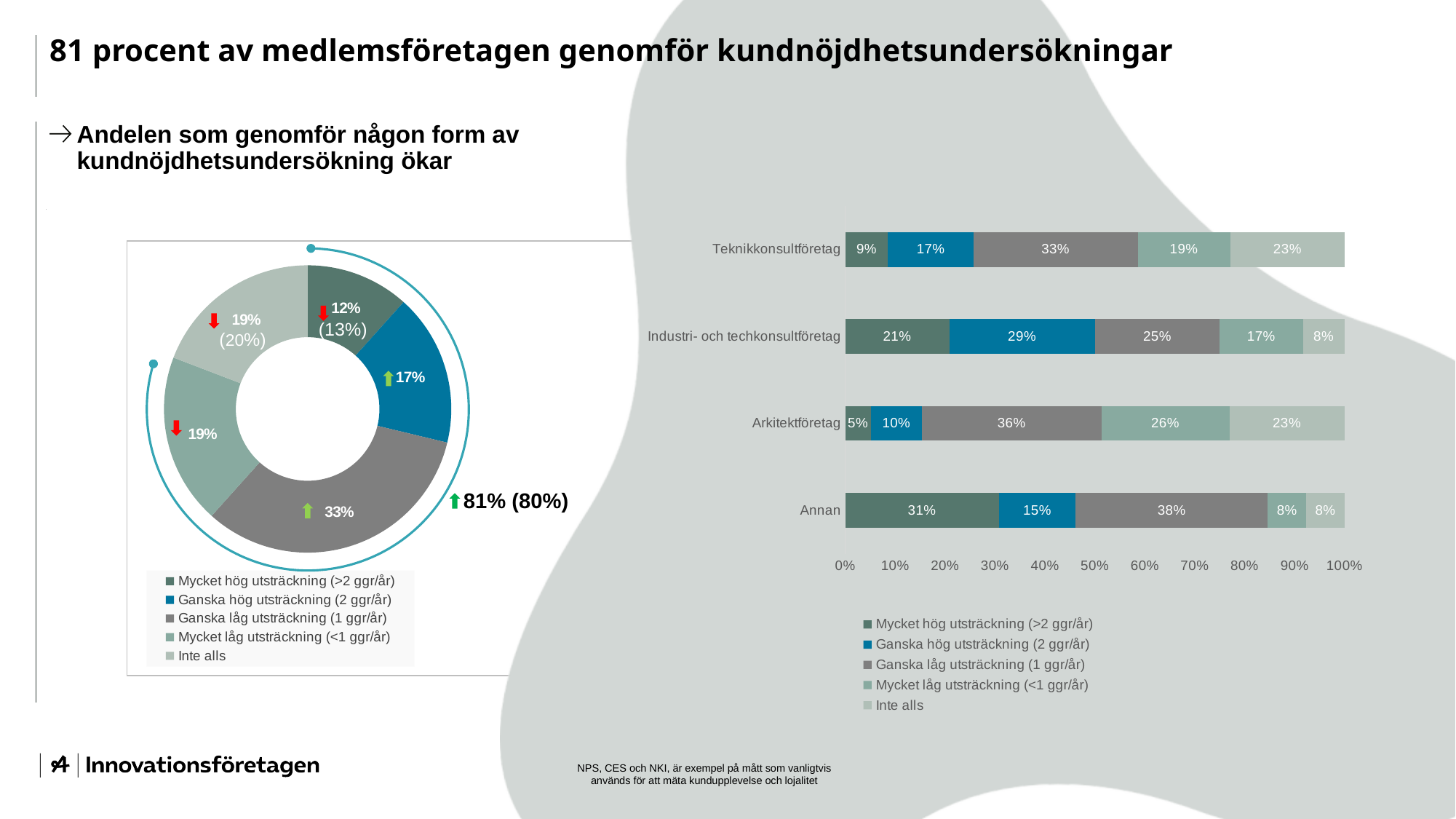
In the stacked bar chart on the right, what is the difference between the 'Ganska låg utsträckning (1 ggr/år)' values for Annan and Industri- och techkonsultföretag? 13% In the donut chart on the left, what share is labelled for 'Ganska hög utsträckning (2 ggr/år)'? 17% In the donut chart on the left, which category has the largest share? Ganska låg utsträckning (1 ggr/år) In the stacked bar chart on the right, what is the value for 'Inte alls' for Arkitektföretag? 23% In the stacked bar chart on the right, which category has the highest value for 'Mycket hög utsträckning (>2 ggr/år)'? Annan In the stacked bar chart on the right, what is the value for 'Ganska hög utsträckning (2 ggr/år)' for Industri- och techkonsultföretag? 29% What kind of chart is shown on the left side of the slide? Donut (pie) chart In the donut chart on the left, what share is labelled for 'Ganska låg utsträckning (1 ggr/år)'? 33% What kind of chart is shown on the right side of the slide? Stacked bar chart In the stacked bar chart on the right, how many categories are shown on the vertical axis? 4 In the stacked bar chart on the right, which category has the lowest value for 'Mycket hög utsträckning (>2 ggr/år)'? Arkitektföretag In the donut chart on the left, how many entries does the legend list? 5